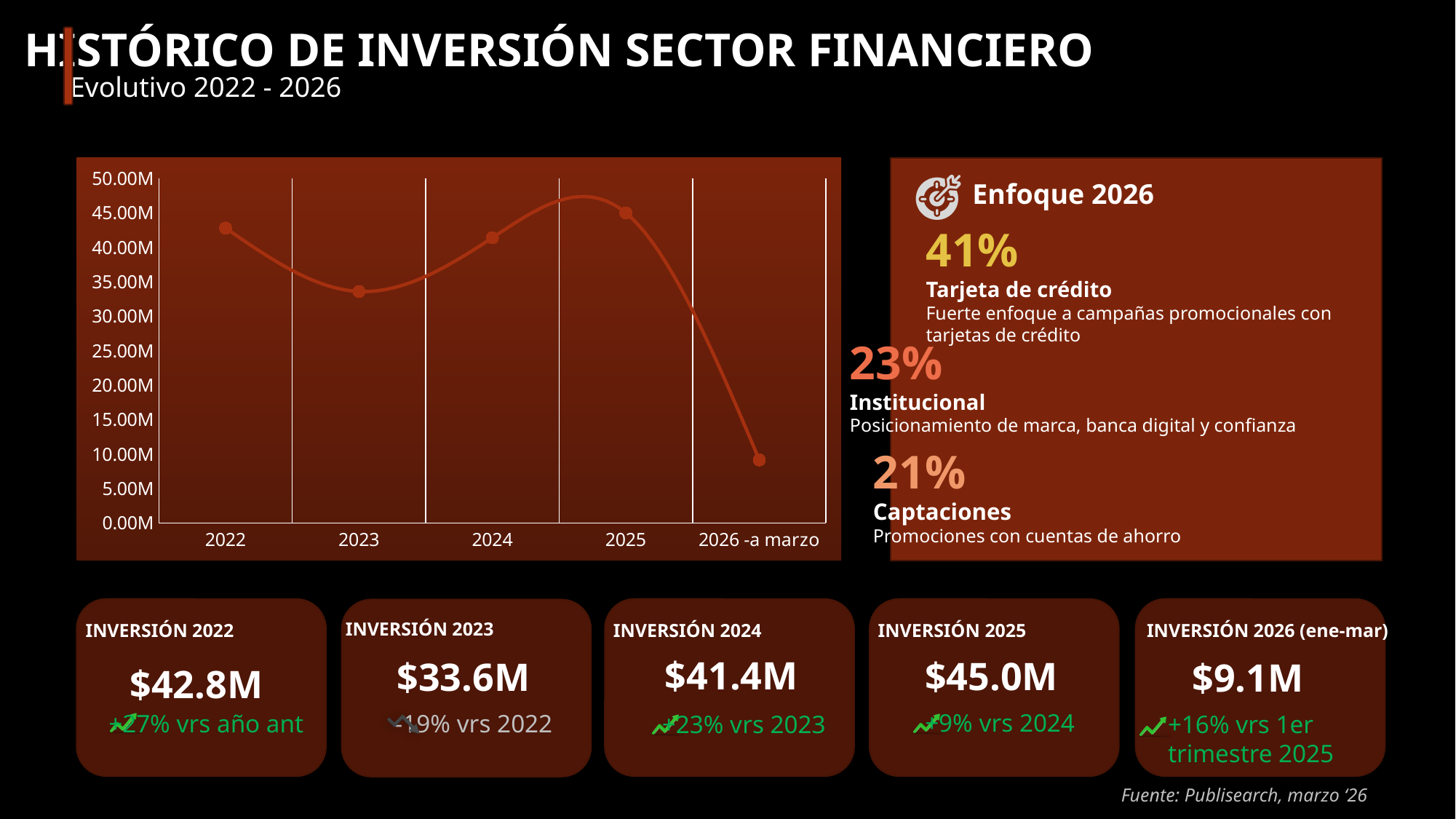
Which year has the highest investment value on the chart? 2025 Which point on the chart has the lowest investment value? 2026 -a marzo What is the difference between the investment in 2022 and in 2023, using the values printed on the slide? $9.2M According to the slide, what was the investment in 2023? $33.6M Does the line rise or fall from 2023 to 2025? rises According to the slide, what was the investment in 2025? $45.0M Which is larger, the investment in 2022 or in 2024? 2022 Is the value plotted for 2025 greater or less than 40.00M? greater Is the value plotted for 2023 greater or less than 35.00M? less According to the slide, what was the investment in 2026 (ene-mar)? $9.1M What kind of chart is shown on the slide? line chart How many data points are plotted on the line chart? 5